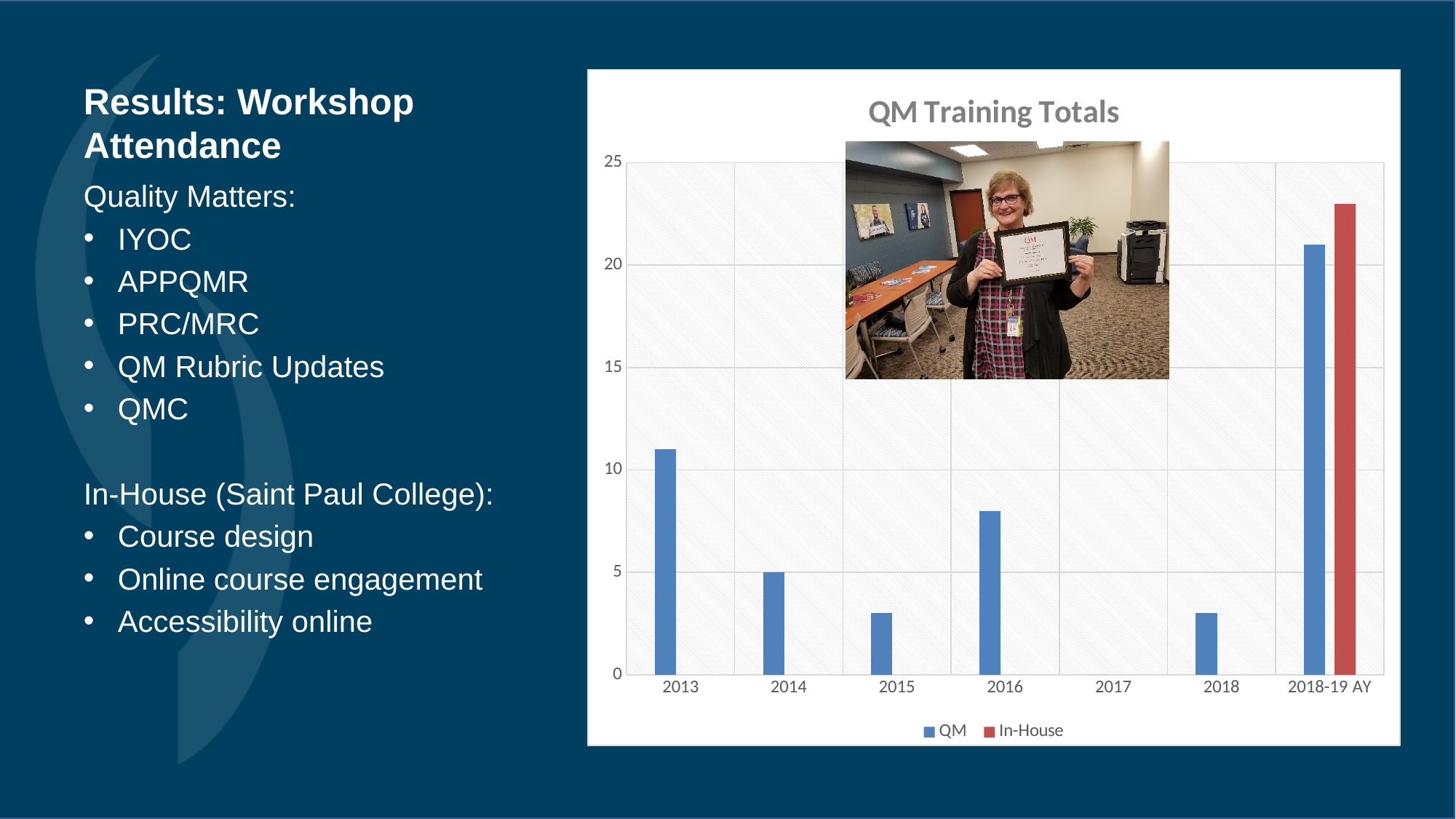
Which category has the highest QM value? 2018-19 AY Is the QM value for 2018-19 AY greater or less than 20? greater What is the title of the chart? QM Training Totals How many categories are shown on the x axis of the chart? 7 What kind of chart is shown on the slide? bar chart How many series does the chart legend list? 2 Which series is shown in red in the chart? In-House Is the QM value for 2016 greater or less than 5? greater Is the QM value for 2015 greater or less than 5? less Which is larger, the QM value for 2013 or the QM value for 2016? 2013